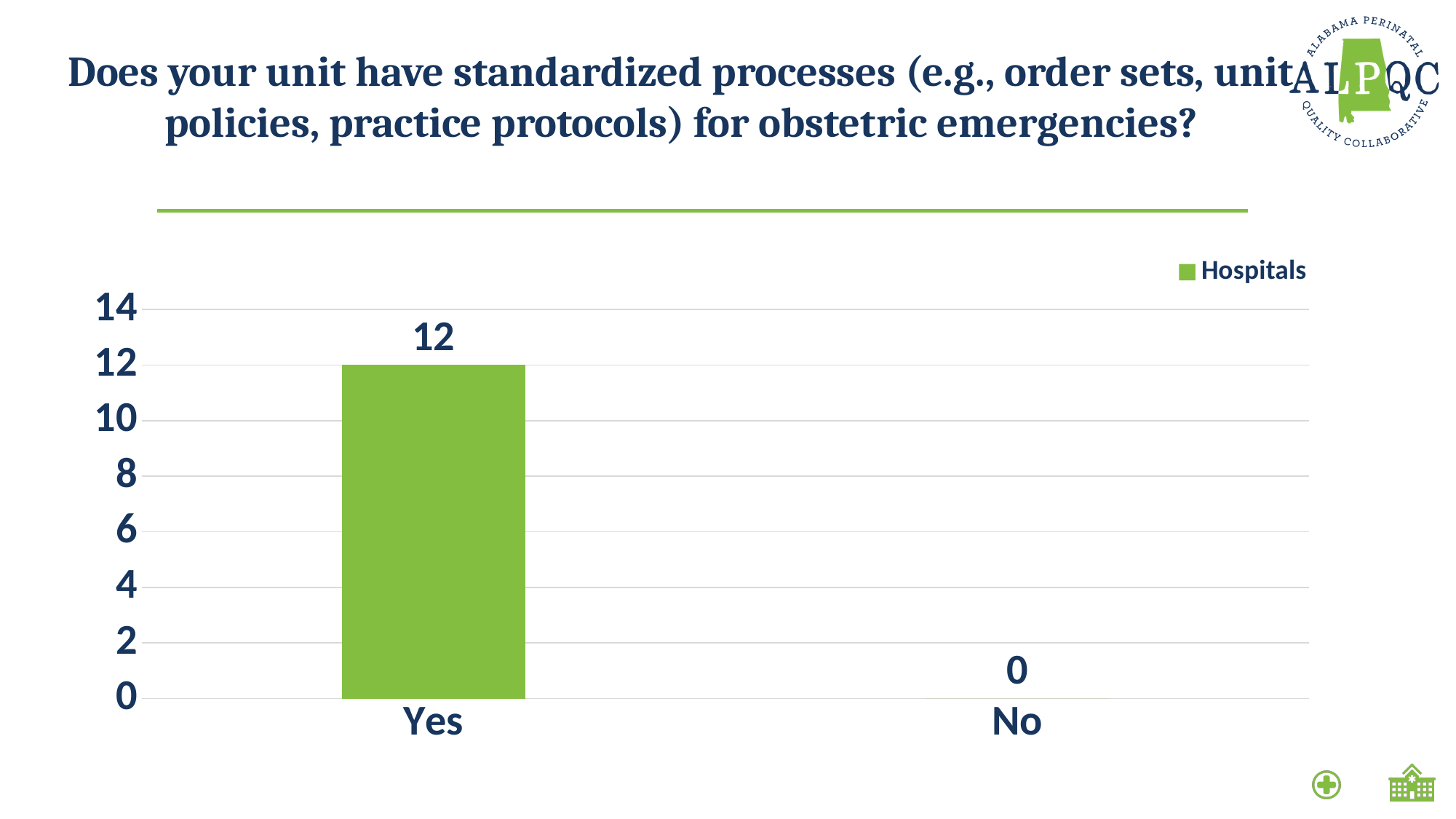
Which is larger, the value for Yes or the value for No? Yes What kind of chart is shown on the slide? bar chart How many hospitals answered No? 0 What series name is shown in the legend? Hospitals Is the value for Yes greater or less than 10? greater Which category has the lowest value? No How many hospitals answered Yes? 12 Which category has the highest value? Yes What is the total of the Yes and No values? 12 How many categories are shown on the x axis? 2 What is the difference between the Yes and No values? 12 How many series does the legend list? 1